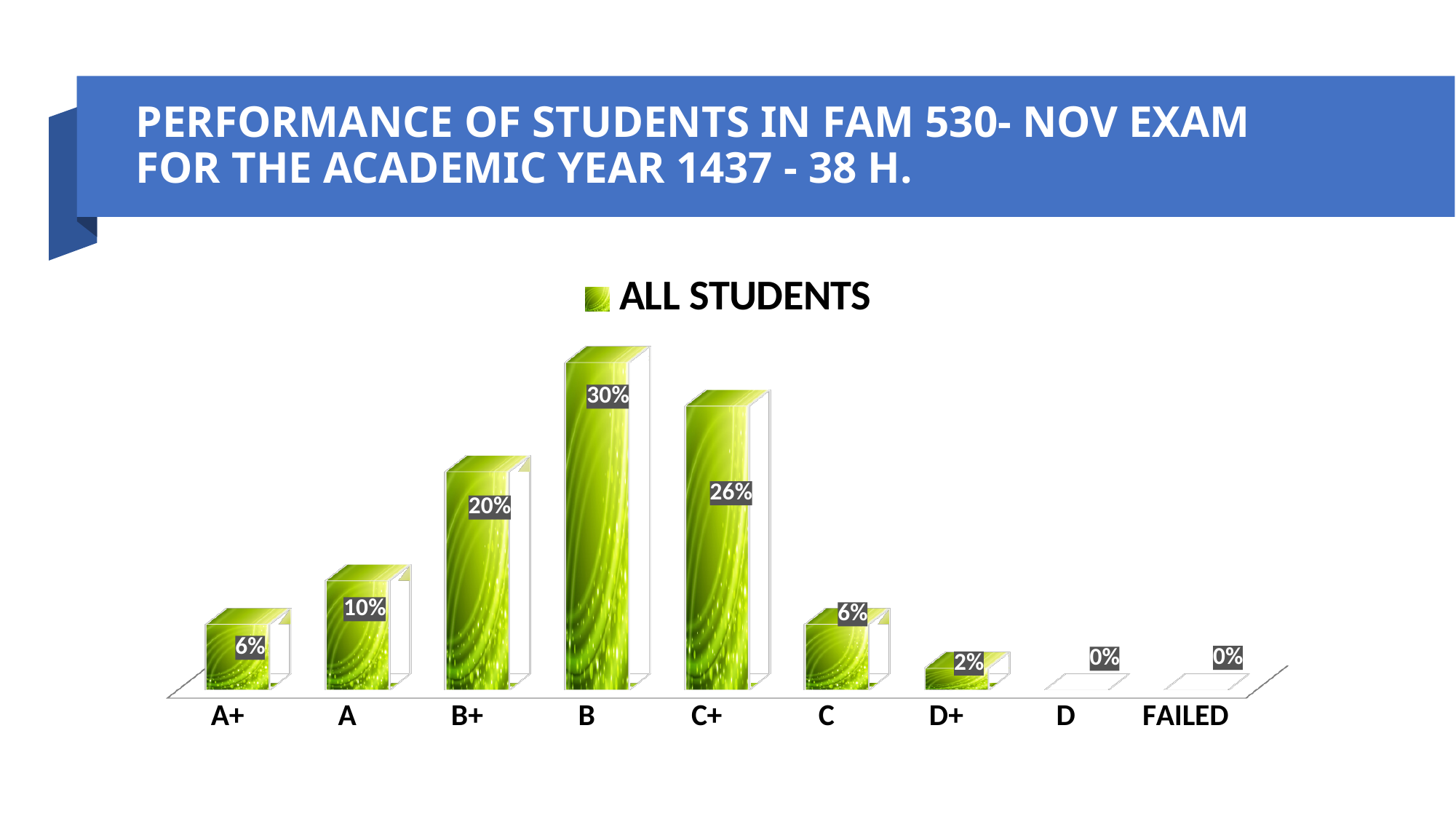
What percentage of students received a B grade? 30% What is the difference in percentage between the B and C+ grade categories? 4% How many series does the legend list? 1 Which grade category has the highest percentage of students? B What percentage of students received an A grade? 10% How many grade categories are shown on the x axis? 9 Which has a larger percentage of students, B+ or C+? C+ What is the difference in percentage between the B+ and A grade categories? 10% What is the name of the series shown in the legend? ALL STUDENTS What kind of chart is shown on the slide? Bar chart What percentage of students received a C+ grade? 26% What percentage of students received a D+ grade? 2%